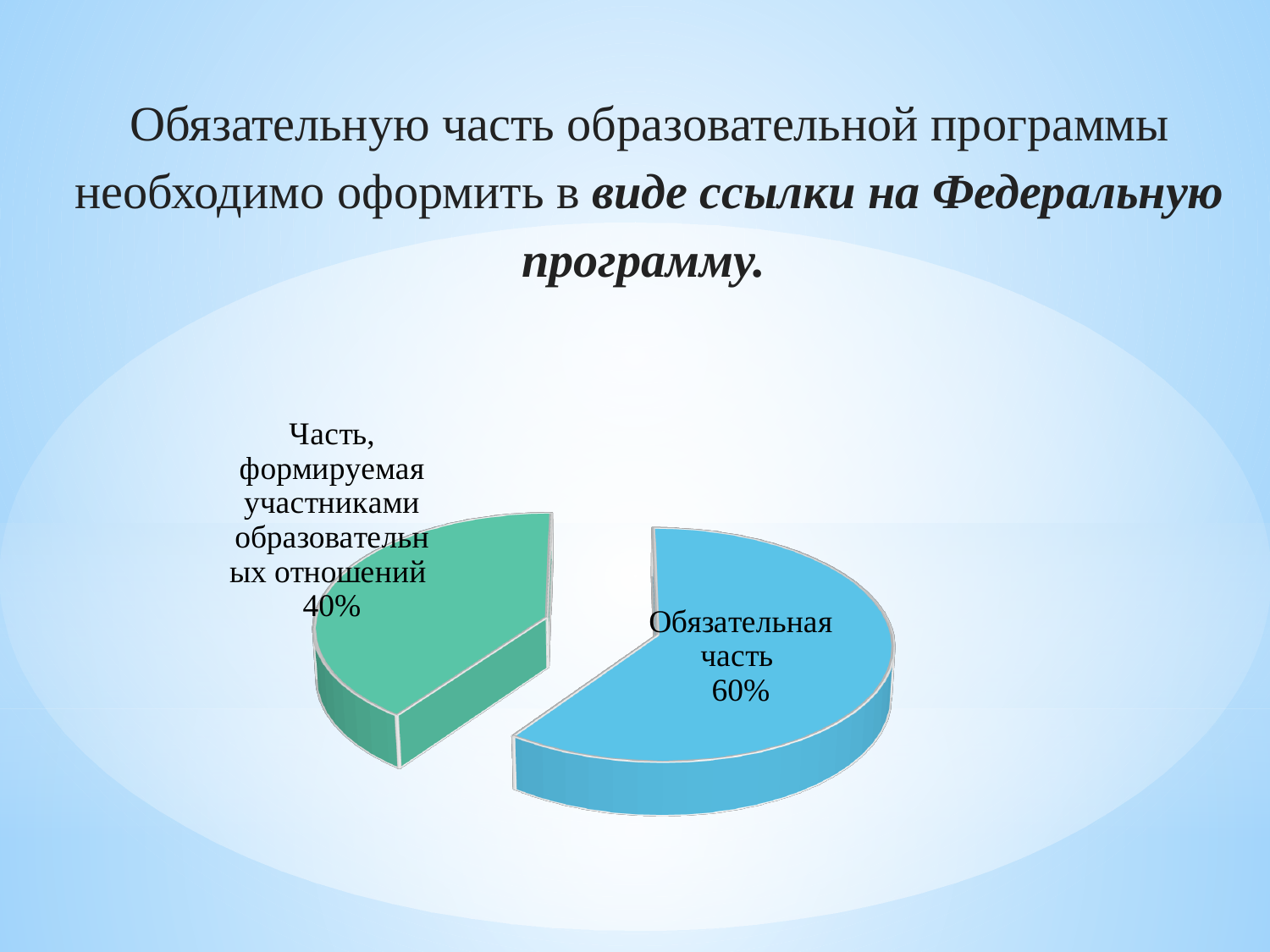
Which slice of the pie is the smallest? Часть, формируемая участниками образовательных отношений What colour is the "Часть, формируемая участниками образовательных отношений" slice? green What colour is the "Обязательная часть" slice? blue Is the share for "Обязательная часть" greater or less than 50%? greater Which is larger: "Обязательная часть" or "Часть, формируемая участниками образовательных отношений"? Обязательная часть What kind of chart is shown on the slide? pie chart What is the difference in percentage points between "Обязательная часть" and "Часть, формируемая участниками образовательных отношений"? 20% Which slice of the pie is the largest? Обязательная часть What share of the pie does "Часть, формируемая участниками образовательных отношений" have? 40% What share of the pie does "Обязательная часть" have? 60% How many slices does the pie chart have? 2